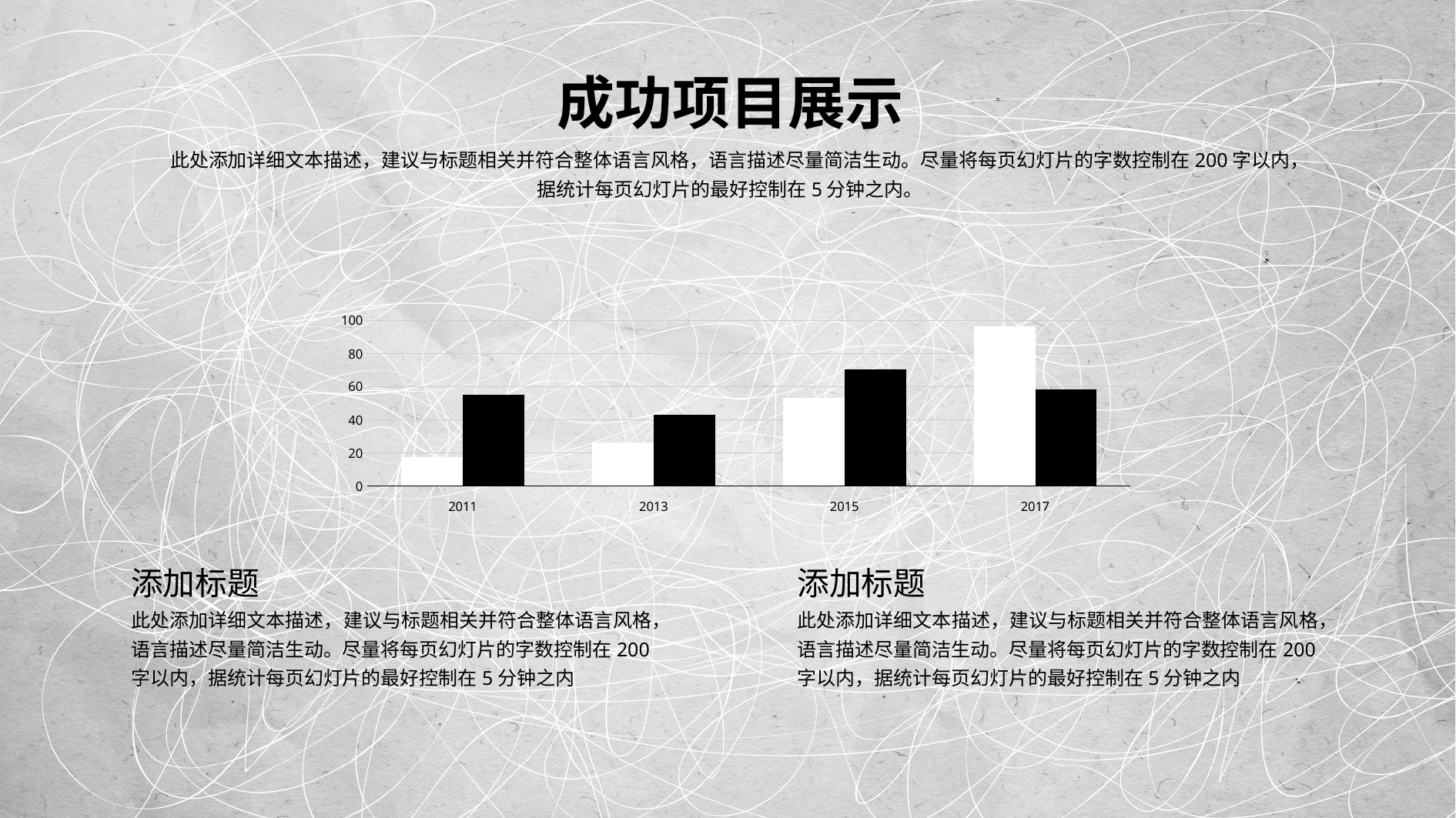
What is the highest value shown on the vertical axis of the chart? 100 How many categories are shown on the x axis of the chart? 4 Is the value of the white bar for 2017 greater or less than 80? greater Is the value of the white bar for 2011 greater or less than 40? less In 2017, which bar is taller, the white bar or the black bar? white bar What kind of chart is shown on the slide? bar chart In 2011, which bar is taller, the white bar or the black bar? black bar Which year has the tallest black bar? 2015 Which year has the shortest white bar? 2011 Which year has the tallest white bar? 2017 Is the value of the black bar for 2015 greater or less than 60? greater Do the white bars rise or fall from 2011 to 2017? rise